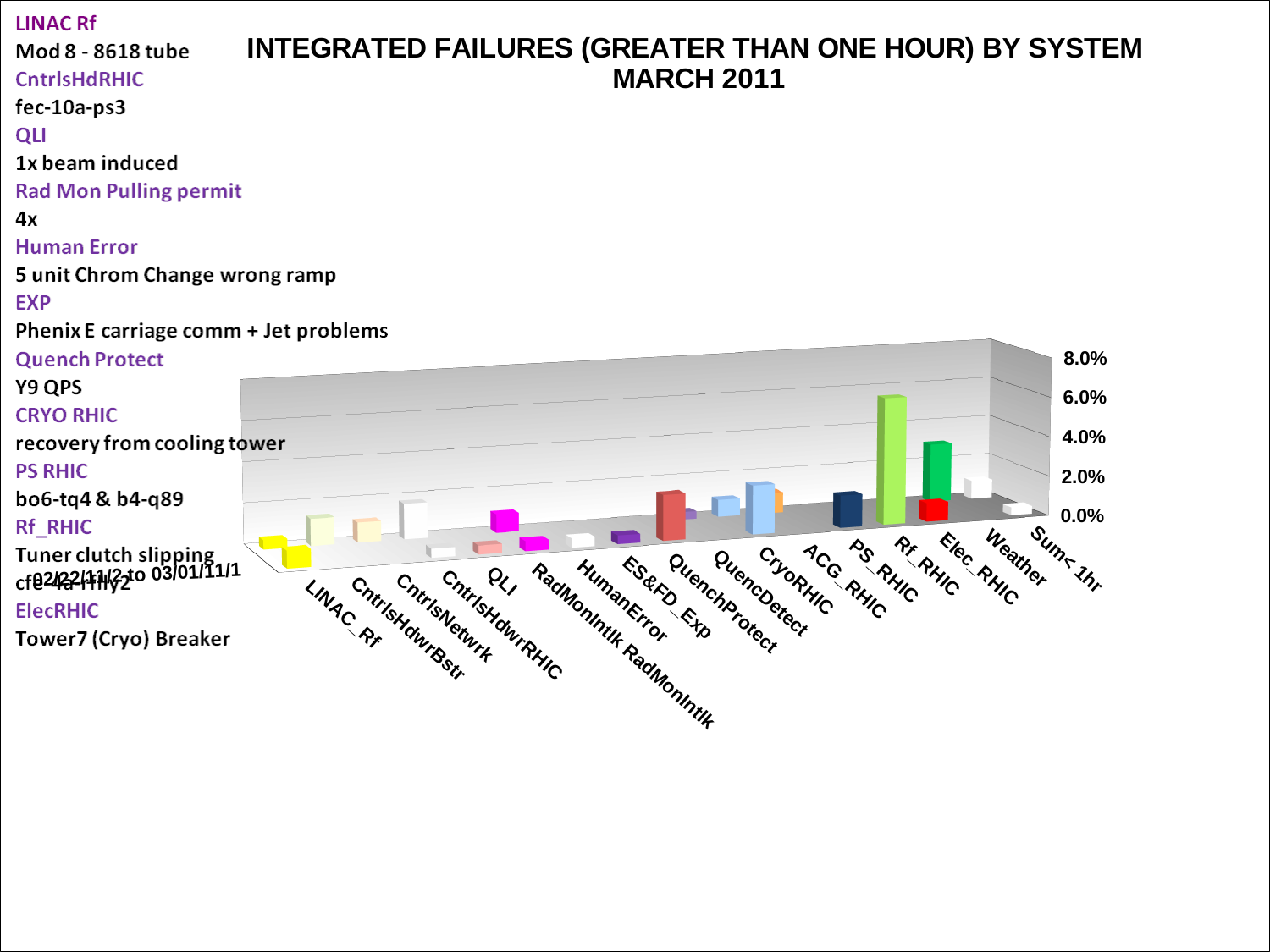
Is the value for Elec_RHIC greater or less than 2.0%? less Which is larger, the value for PS_RHIC or the value for Rf_RHIC? Rf_RHIC Is the value for PS_RHIC greater or less than 8.0%? less What is the title of the chart? INTEGRATED FAILURES (GREATER THAN ONE HOUR) BY SYSTEM MARCH 2011 Which system has the highest bar in the chart? Rf_RHIC What kind of chart is shown on the slide? bar chart Which is larger, the value for Rf_RHIC or the value for Elec_RHIC? Rf_RHIC Is the value for PS_RHIC greater or less than 4.0%? less What is the highest value shown on the vertical axis of the chart? 8.0%